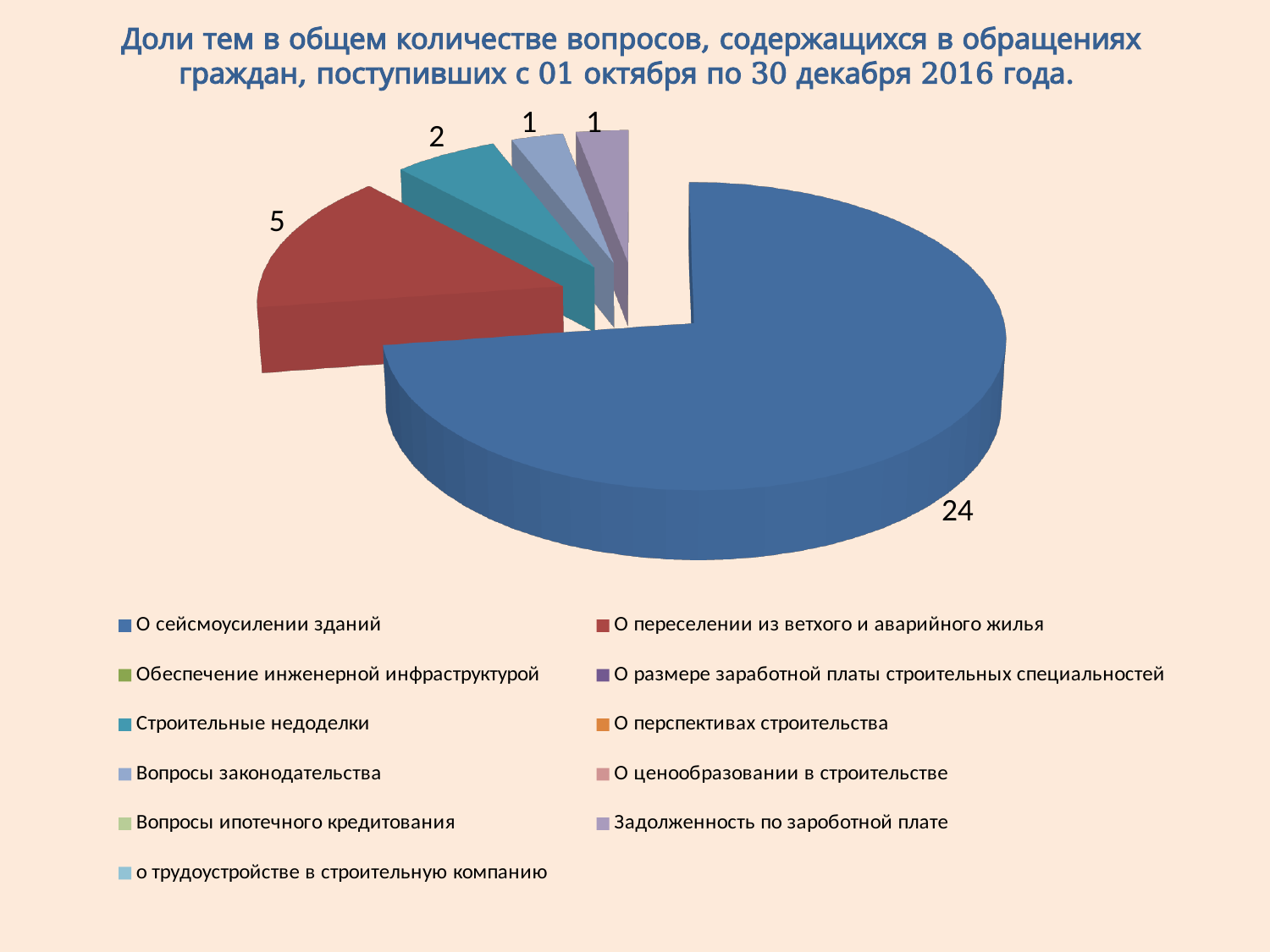
What is the total of all the labelled slice values in the pie? 33 What value is shown for the slice "Вопросы законодательства"? 1 How many slices with data labels are shown in the pie? 5 What kind of chart is shown on the slide? pie chart What value is shown for the slice "Строительные недоделки"? 2 What is the difference between the values for "О сейсмоусилении зданий" and "О переселении из ветхого и аварийного жилья"? 19 What value is shown for the slice "О сейсмоусилении зданий"? 24 What colour is the slice for "О переселении из ветхого и аварийного жилья"? red How many entries does the legend list? 11 Which category has the largest slice of the pie? О сейсмоусилении зданий What value is shown for the slice "О переселении из ветхого и аварийного жилья"? 5 Which is larger: the value for "О переселении из ветхого и аварийного жилья" or the value for "Строительные недоделки"? О переселении из ветхого и аварийного жилья